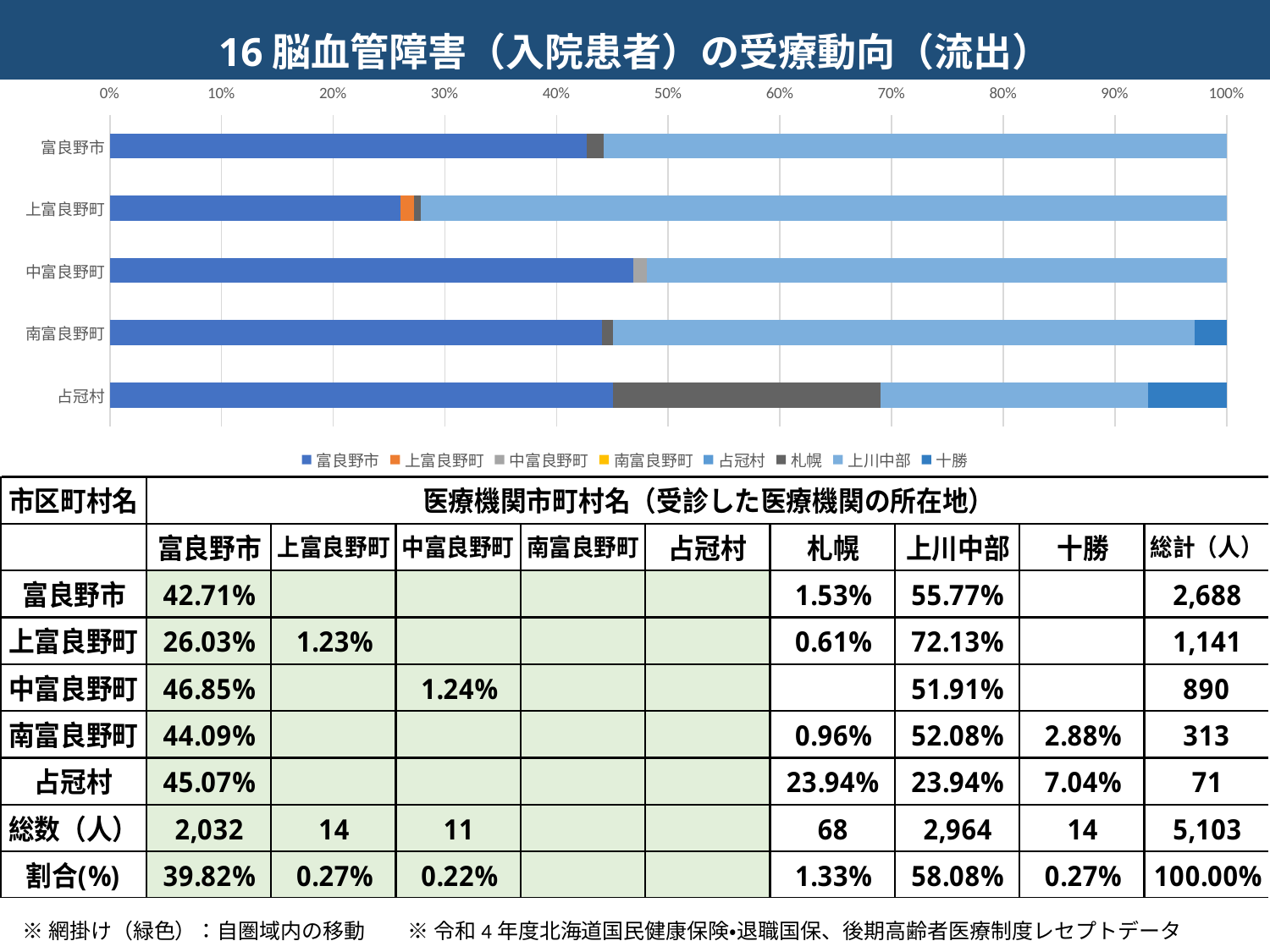
What is the difference between the 上川中部 share for 上富良野町 and for 富良野市? 16.36 percentage points Which municipality has the highest share of patients going to 上川中部? 上富良野町 What share of 富良野市 patients received care in 富良野市? 42.71% Which has a larger share of patients going to 富良野市: 中富良野町 or 南富良野町? 中富良野町 Which municipality has the lowest share of patients going to 富良野市? 上富良野町 How many series does the chart legend list? 8 What share of 占冠村 patients received care in 札幌? 23.94% What share of 南富良野町 patients received care in 十勝? 2.88% How many municipalities (categories) are plotted on the y axis of the chart? 5 Is the 札幌 share for 占冠村 greater or less than 20%? greater What kind of chart is shown on the slide? bar chart What is the title of the chart? 16 脳血管障害（入院患者）の受療動向（流出）